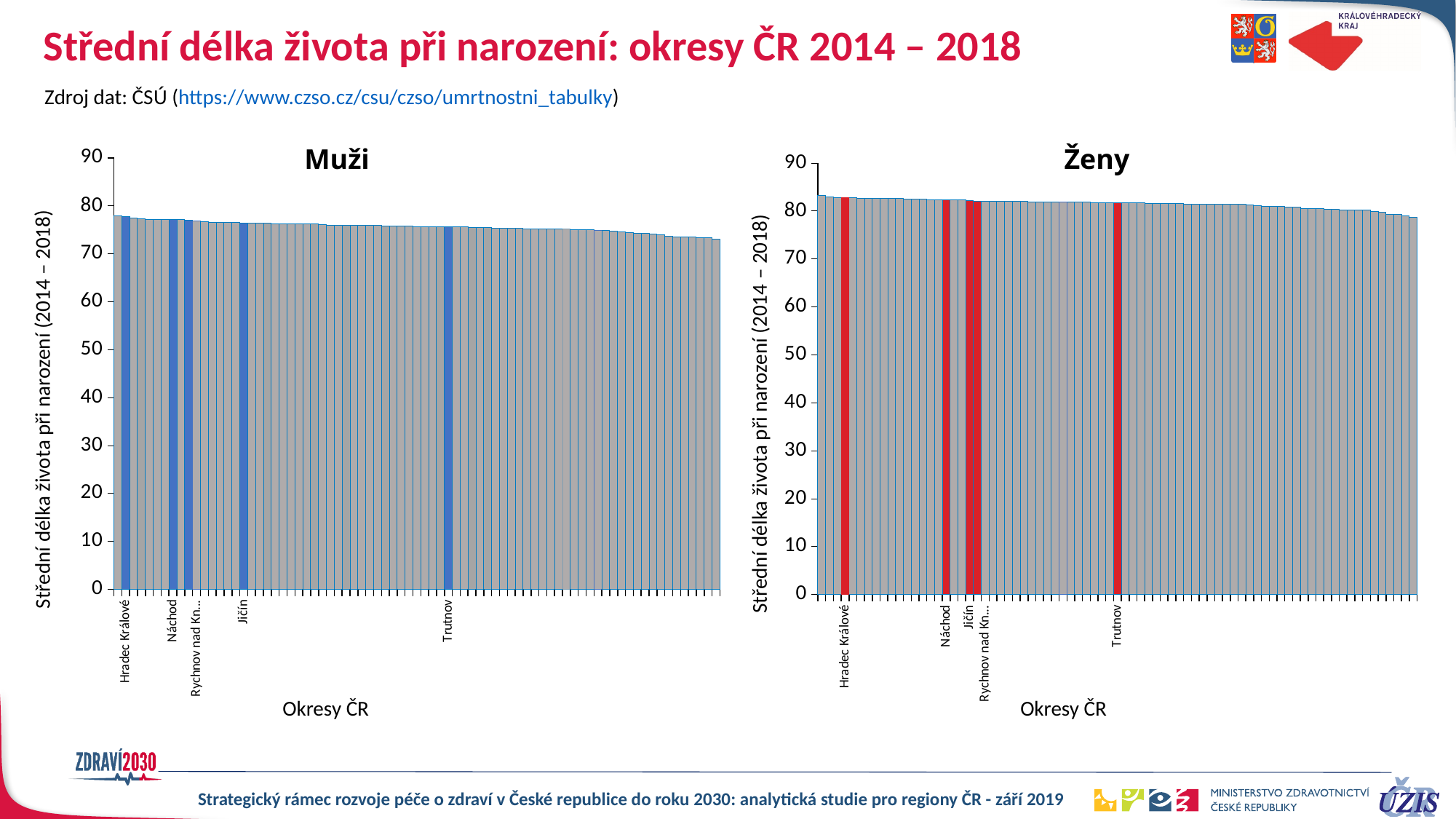
In the "Ženy" chart, which has the higher value, Hradec Králové or Trutnov? Hradec Králové In the "Ženy" chart, do the values rise or fall from left to right along the x axis? fall In the "Muži" chart, is the value for Trutnov greater or less than 80? less What is the x-axis label of the "Muži" chart? Okresy ČR In the "Muži" chart, is the value for Hradec Králové greater or less than 70? greater In the "Ženy" chart, is the value for Trutnov greater or less than 70? greater In the "Muži" chart, which has the higher value, Hradec Králové or Trutnov? Hradec Králové What kind of chart is the "Ženy" chart? bar chart In the "Muži" chart, do the values rise or fall from left to right along the x axis? fall What colour are the highlighted bars in the "Ženy" chart? red What kind of chart is the "Muži" chart? bar chart